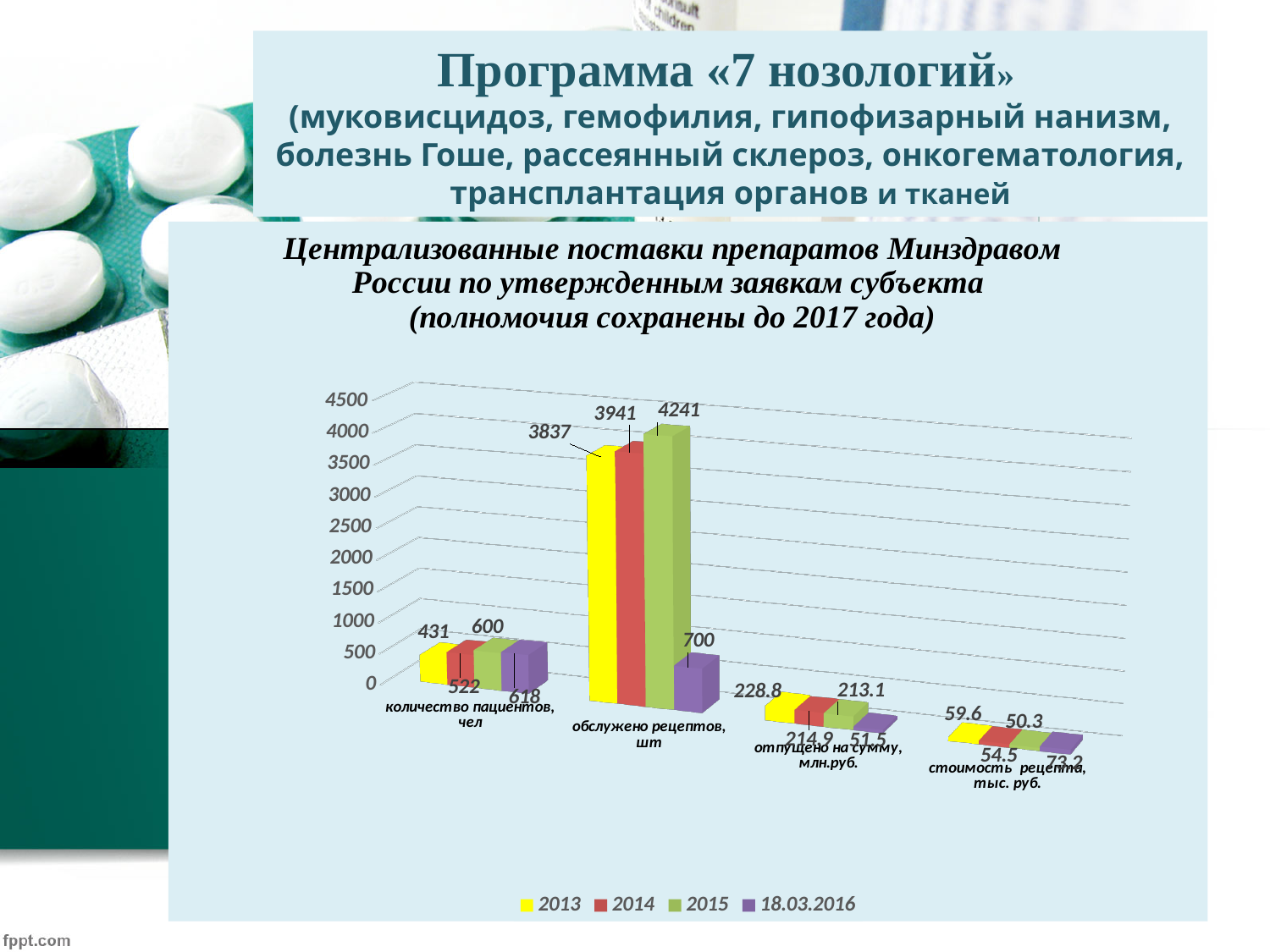
What is the value for 2015 in the category "обслужено рецептов, шт"? 4241 What is the value for 2013 in the category "количество пациентов, чел"? 431 What type of chart is shown on the slide? bar chart What is the difference between the 2015 and 2013 values in the category "обслужено рецептов, шт"? 404 Which series has the lowest value in the category "количество пациентов, чел"? 2013 Do the values for "количество пациентов, чел" rise or fall from 2013 to 18.03.2016? rise Which series has the highest value in the category "обслужено рецептов, шт"? 2015 What is the value for 2014 in the category "стоимость рецепта, тыс. руб."? 54.5 How many categories are shown on the x axis of the chart? 4 How many series does the legend list? 4 Which is larger in the category "стоимость рецепта, тыс. руб.": the value for 2013 or for 2015? 2013 What is the value for 18.03.2016 in the category "отпущено на сумму, млн.руб."? 51.5